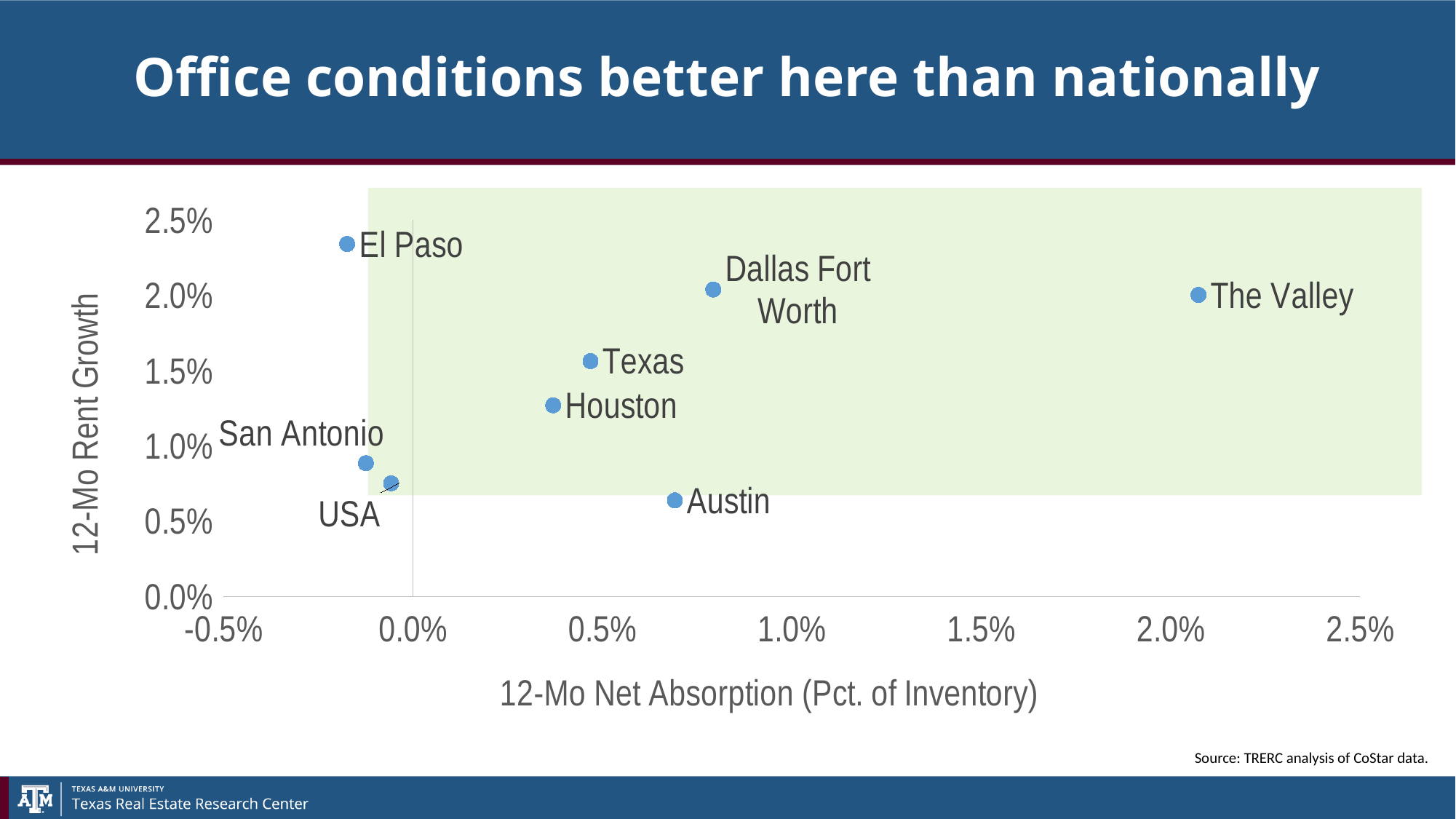
What kind of chart is shown on the slide? Scatter chart How many labeled data points are plotted on the chart? 8 Is the 12-Mo Net Absorption for El Paso greater or less than 0.0%? less What is the label of the x axis? 12-Mo Net Absorption (Pct. of Inventory) Which has higher 12-Mo Rent Growth, Texas or Houston? Texas Is the 12-Mo Net Absorption for The Valley greater or less than 1.5%? greater Which point has the highest 12-Mo Rent Growth? El Paso Is the 12-Mo Rent Growth for Houston greater or less than 1.5%? less Which point has the highest 12-Mo Net Absorption? The Valley Which has higher 12-Mo Net Absorption, The Valley or Houston? The Valley